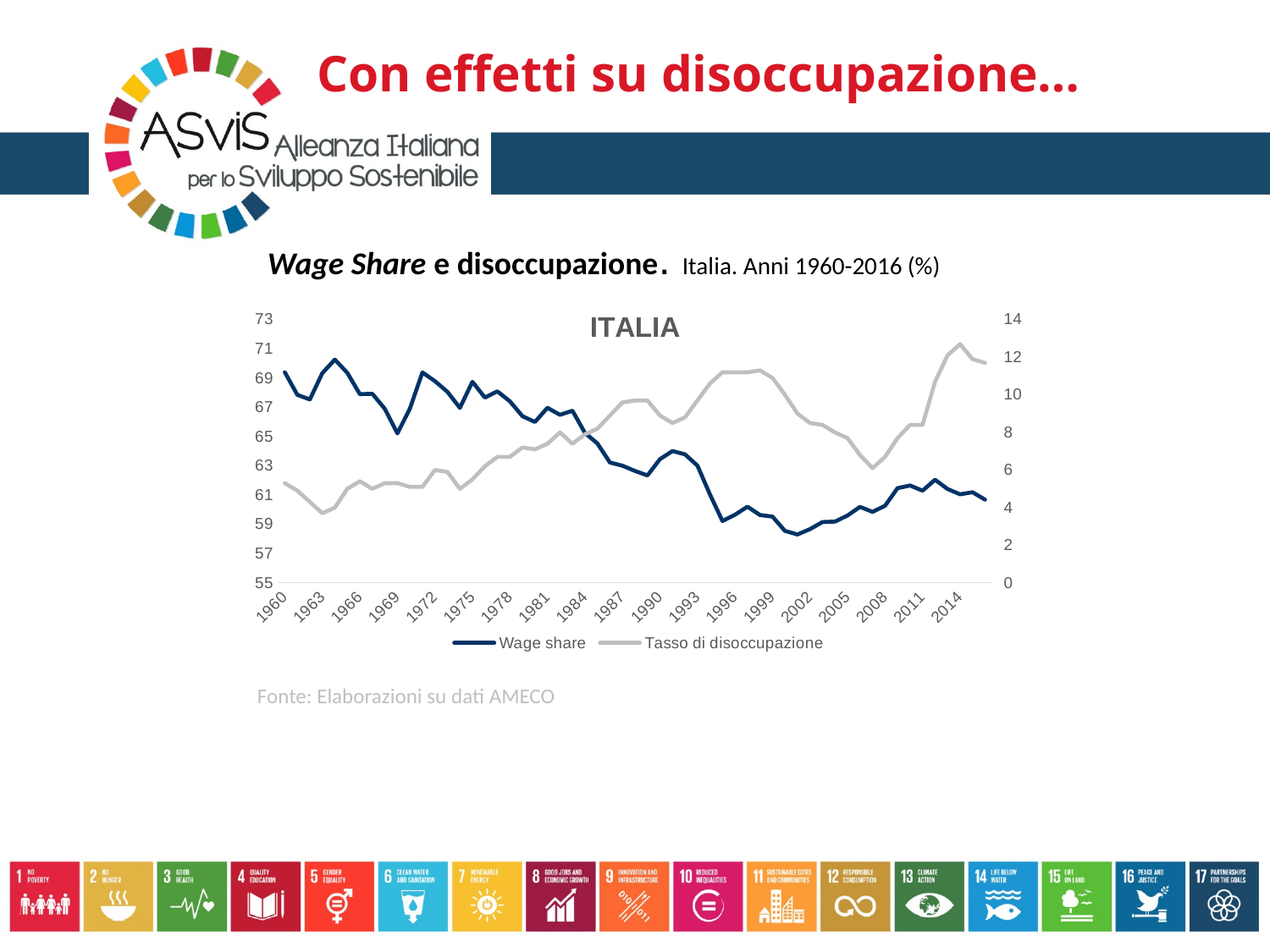
What kind of chart is shown on the slide? line chart Which year has the highest Tasso di disoccupazione value? 2014 What are the two series named in the legend? Wage share; Tasso di disoccupazione Does the Wage share series overall rise or fall from 1960 to 2016? fall Does the Tasso di disoccupazione series overall rise or fall from 1960 to 2016? rise What is the title printed inside the chart area? ITALIA Is the Wage share value in 1960 greater or less than 67? greater Is the Tasso di disoccupazione value in 2014 greater or less than 10? greater How many series does the legend list? 2 Is the Tasso di disoccupazione value in 1963 greater or less than 6? less Which is larger, the Wage share value in 1960 or in 2016? 1960